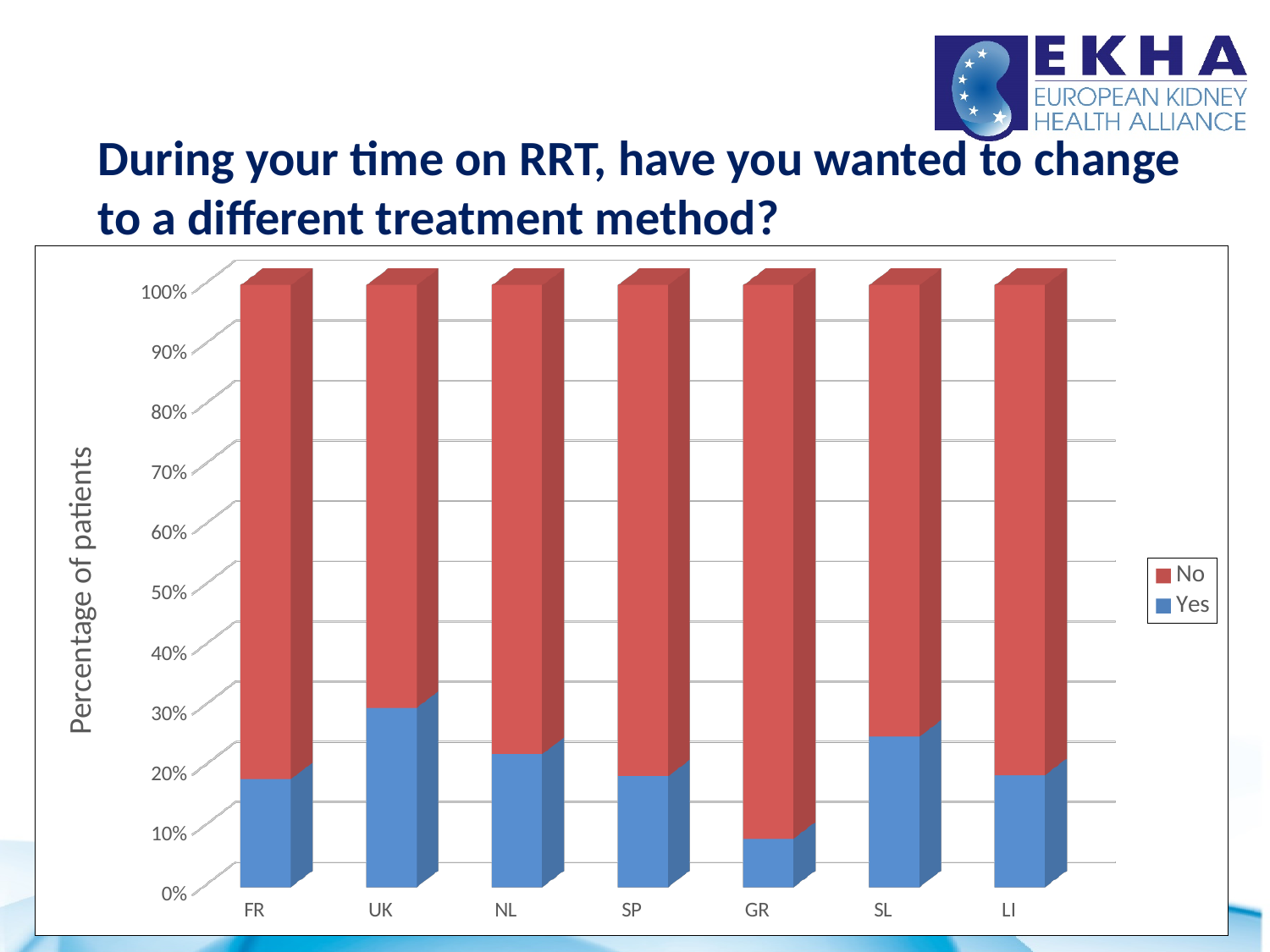
Is the Yes value for GR greater or less than 20%? less How many countries are shown along the x axis of the chart? 7 Which colour represents the No series in the chart? Red Is the Yes value for FR greater or less than 30%? less Is the Yes value for SL greater or less than 20%? greater How many series does the chart's legend list? 2 What is the label on the vertical axis of the chart? Percentage of patients What kind of chart is shown on the slide? Stacked bar chart Which country has the highest share of patients answering Yes? UK Which has a larger Yes share, UK or GR? UK Which country has the lowest share of patients answering Yes? GR